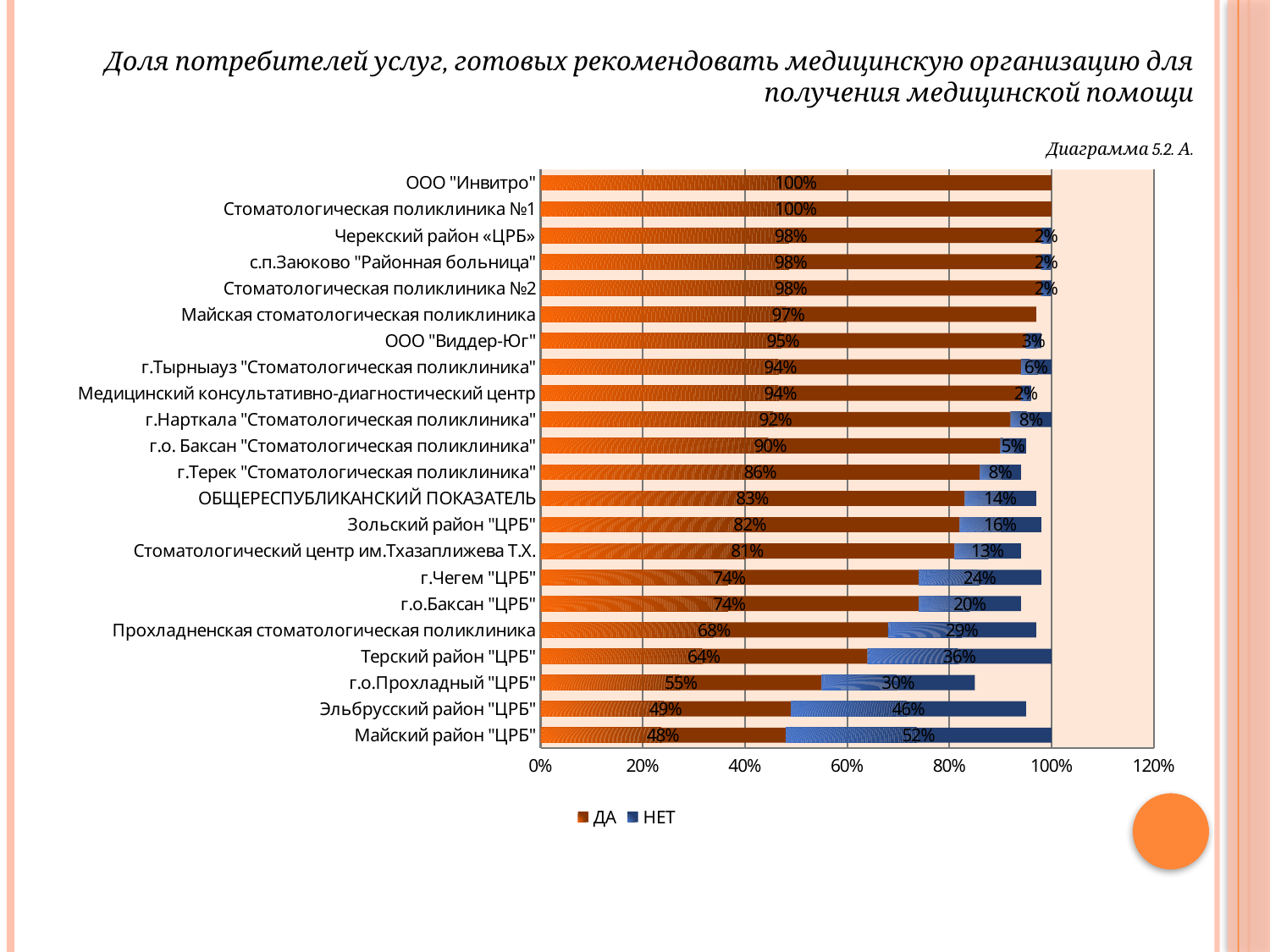
How many organizations (categories) are plotted in the chart? 22 What is the difference between the ДА values for Зольский район "ЦРБ" and Эльбрусский район "ЦРБ"? 33% How many series does the legend list? 2 What type of chart is shown on the slide? Stacked horizontal bar chart Which organization has the lowest ДА value? Майский район "ЦРБ" What is the НЕТ value for Терский район "ЦРБ"? 36% What is the label of the diagram shown above the chart? Диаграмма 5.2. А. What is the total of the stacked bar for г.Чегем "ЦРБ" (ДА plus НЕТ)? 98% Which has a larger ДА value: г.о.Прохладный "ЦРБ" or Прохладненская стоматологическая поликлиника? Прохладненская стоматологическая поликлиника What is the ДА value for ОБЩЕРЕСПУБЛИКАНСКИЙ ПОКАЗАТЕЛЬ? 83% What is the ДА value for г.Терек "Стоматологическая поликлиника"? 86% Which organization has the highest НЕТ value? Майский район "ЦРБ"